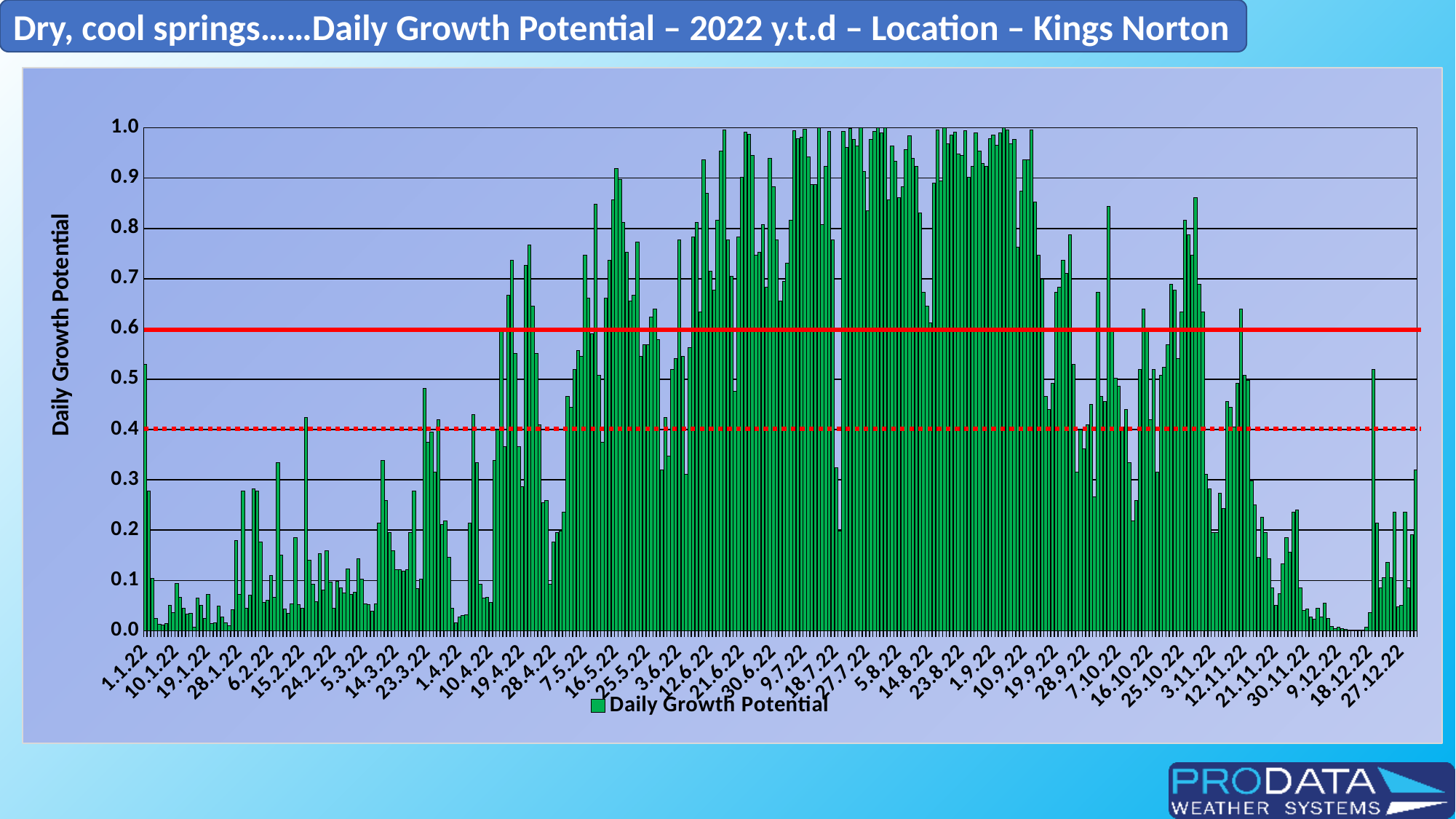
Is the value for 9.12.22 greater or less than 0.1? less What kind of chart is shown on the slide? Bar chart What is the lowest value shown on the vertical axis? 0.0 What is the name of the series shown in the legend? Daily Growth Potential How many series does the legend list? 1 Is the value for 1.1.22 greater or less than 0.4? greater What is the first date label on the horizontal axis? 1.1.22 Is the value for 10.1.22 greater or less than 0.3? less Do the values generally rise or fall between 1.9.22 and 9.12.22? fall What is the label on the vertical axis of the chart? Daily Growth Potential Do the values generally rise or fall between 1.1.22 and 9.7.22? rise What is the highest value shown on the vertical axis? 1.0